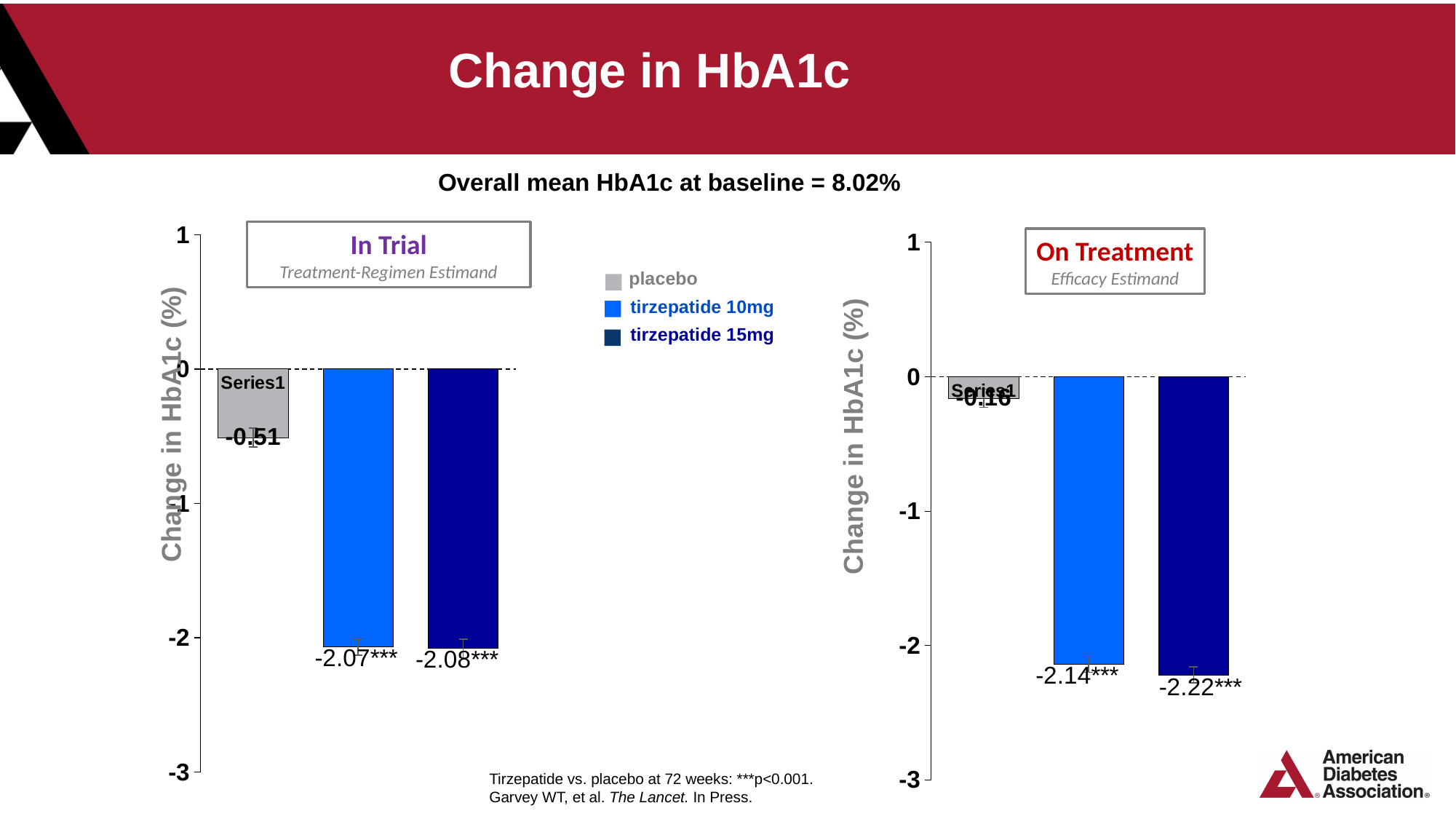
In the In Trial chart, what is the change in HbA1c for tirzepatide 10mg? -2.07 How many series does the legend list? 3 In the In Trial chart, which group shows the smallest reduction in HbA1c? placebo In the In Trial chart, which has a larger reduction in HbA1c: placebo or tirzepatide 10mg? tirzepatide 10mg In the On Treatment chart, what is the change in HbA1c for placebo? -0.16 In the On Treatment chart, what is the difference between the HbA1c change for tirzepatide 15mg and placebo? 2.06 What type of chart is the In Trial chart? bar chart In the On Treatment chart, which group shows the largest reduction in HbA1c? tirzepatide 15mg In the On Treatment chart, what is the change in HbA1c for tirzepatide 10mg? -2.14 In the In Trial chart, what is the change in HbA1c for tirzepatide 15mg? -2.08 In the On Treatment chart, what is the change in HbA1c for tirzepatide 15mg? -2.22 In the In Trial chart, what is the change in HbA1c for placebo? -0.51